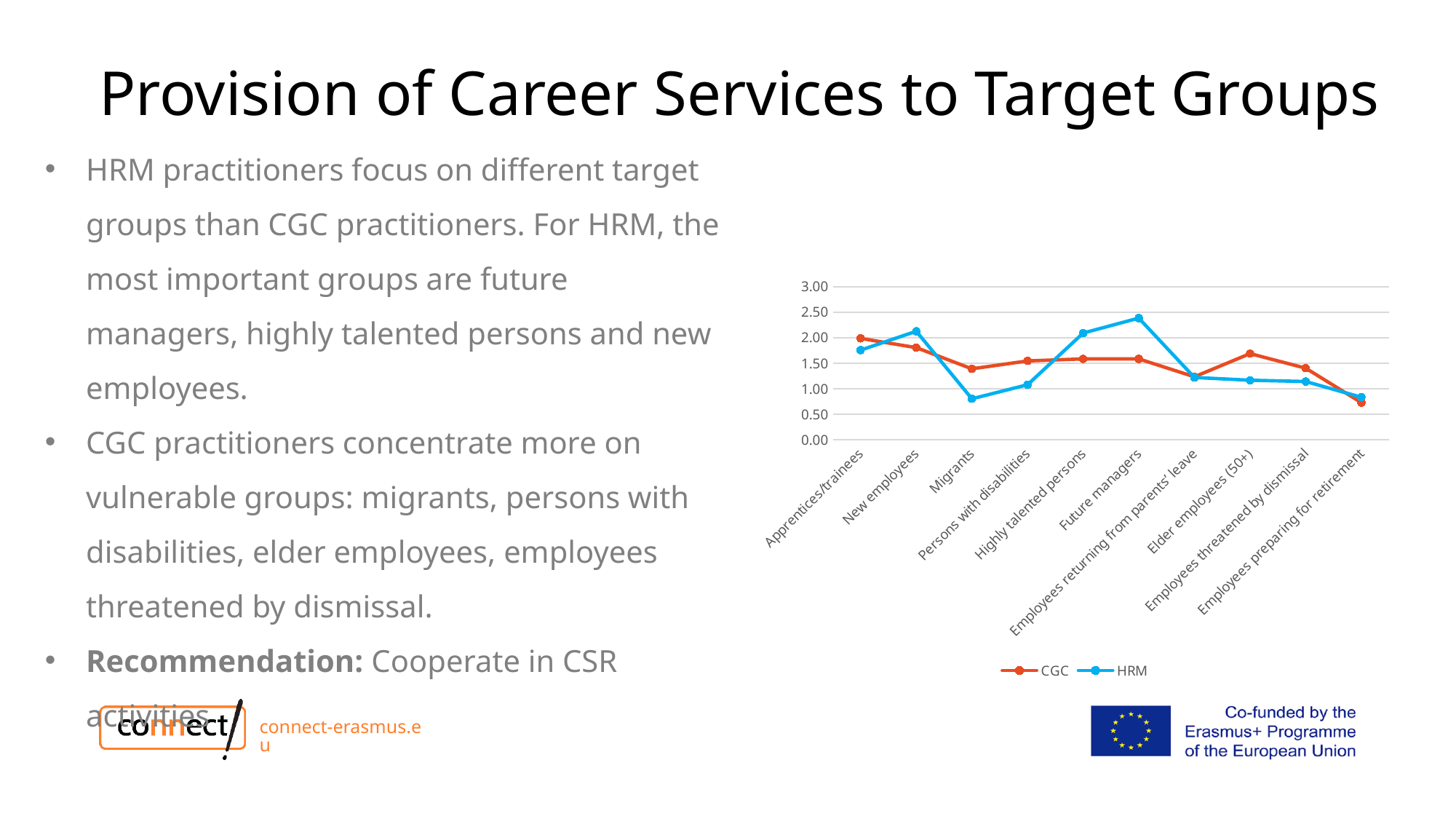
For which target group is the CGC value lowest? Employees preparing for retirement For Migrants, which series has the larger value, CGC or HRM? CGC What kind of chart is shown on the slide? line chart Is the HRM value for Migrants greater or less than 1.00? less For which target group is the HRM value highest? Future managers Which series are listed in the chart's legend? CGC and HRM How many target group categories are plotted along the x axis? 10 For Future managers, which series has the larger value, CGC or HRM? HRM For which target group is the HRM value lowest? Migrants How many series does the chart's legend list? 2 For which target group is the CGC value highest? Apprentices/trainees Is the HRM value for Future managers greater or less than 2.00? greater